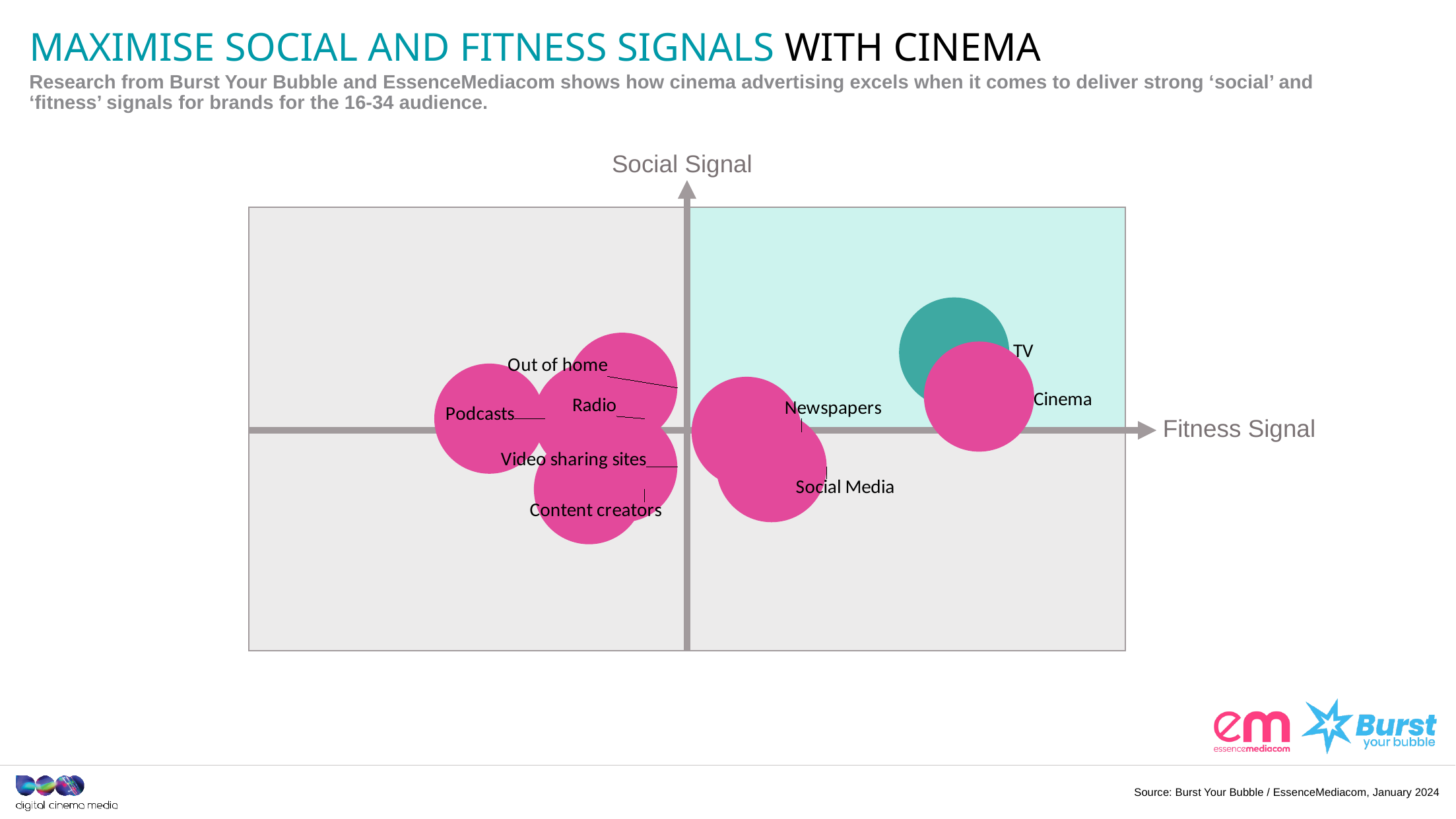
Which media channel has the highest Fitness Signal (is furthest to the right) on the chart? Cinema What kind of chart is shown on the slide? Bubble chart Which two media channels are in the highlighted top-right quadrant of the chart? TV and Cinema How many media channels fall in the highlighted top-right quadrant (high Social Signal and high Fitness Signal)? 2 What is the label of the horizontal axis of the chart? Fitness Signal How many media channels are plotted as bubbles on the chart? 9 Which media channel has the lowest Social Signal (is lowest down) on the chart? Content creators What is the label of the vertical axis of the chart? Social Signal Which media channel has the lowest Fitness Signal (is furthest to the left) on the chart? Podcasts Which media channel has the highest Social Signal (is highest up) on the chart? TV Which has the higher Fitness Signal on the chart, Cinema or Podcasts? Cinema Which has the higher Social Signal on the chart, TV or Social Media? TV